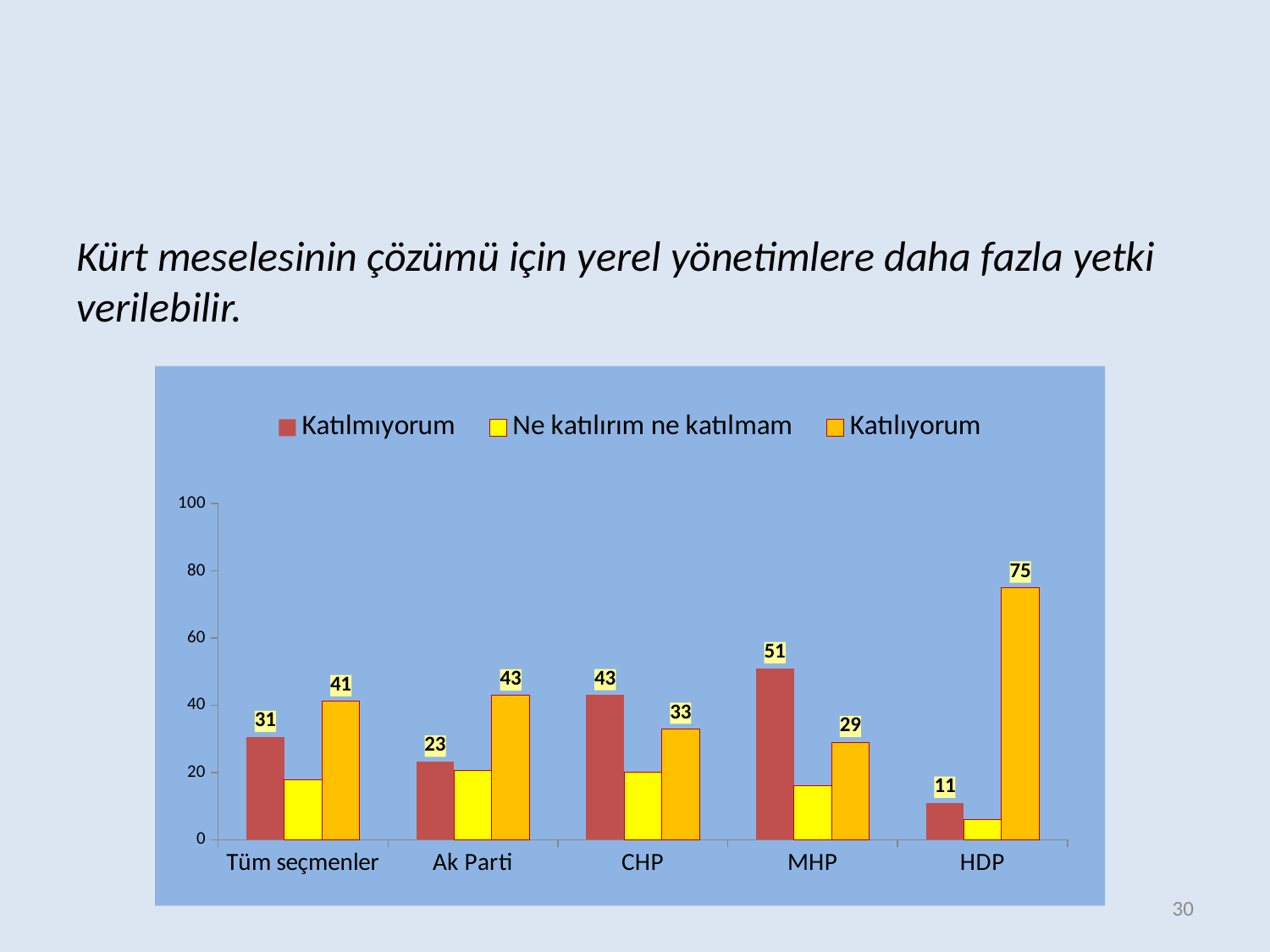
Is the value of Ne katılırım ne katılmam for HDP greater or less than 20? less What is the difference between Katılıyorum and Katılmıyorum for HDP? 64 How many series does the legend list? 3 What kind of chart is shown on the slide? bar chart How many categories are shown on the x axis? 5 What is the value of Katılmıyorum for Ak Parti? 23 What is the value of Katılmıyorum for MHP? 51 Which category has the lowest Katılmıyorum value? HDP Which category has the highest Katılmıyorum value? MHP For CHP, which is larger: Katılmıyorum or Katılıyorum? Katılmıyorum What is the value of Katılıyorum for HDP? 75 Which category has the highest Katılıyorum value? HDP